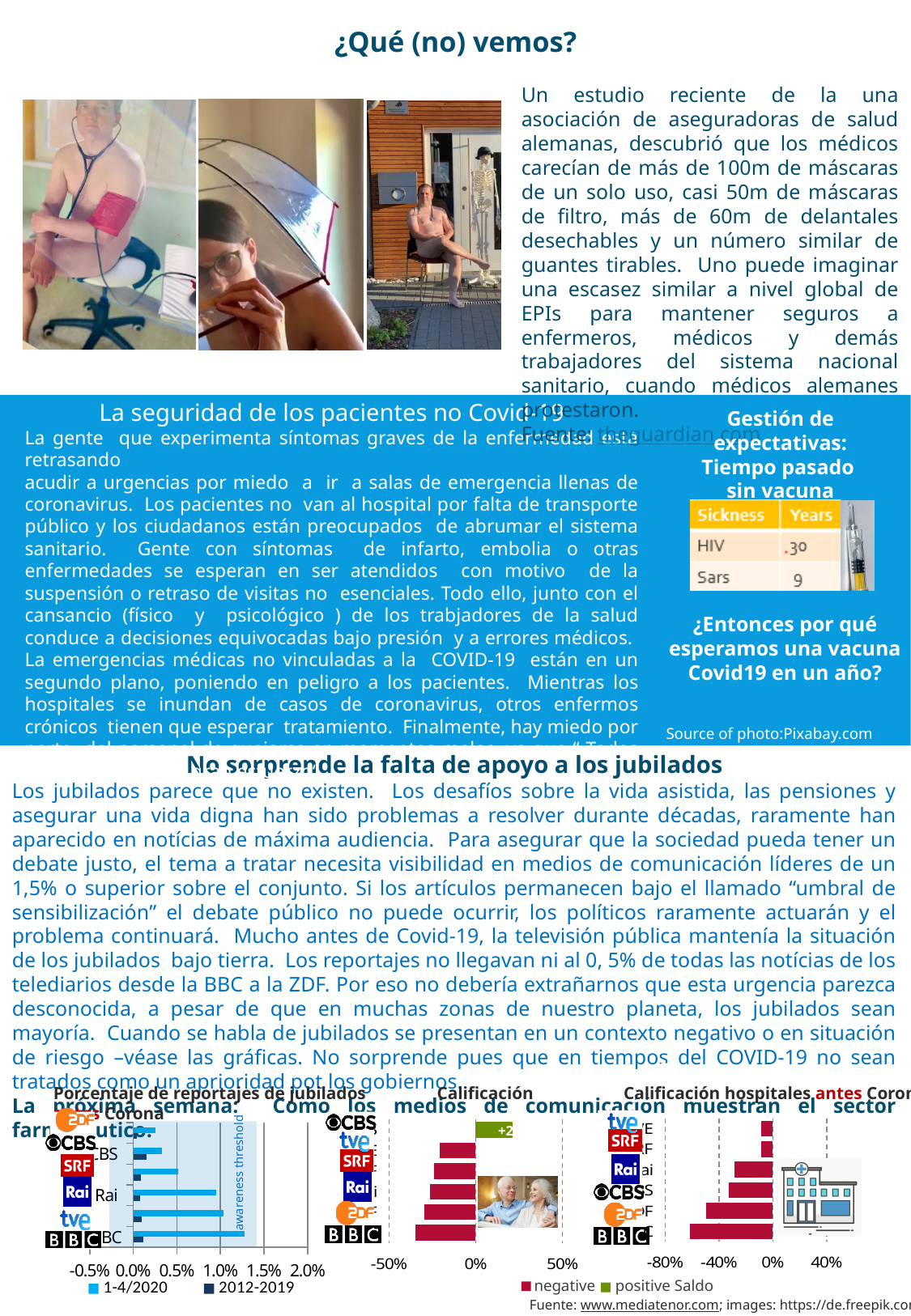
In the 'Porcentaje de reportajes de jubilados' chart, is the 1-4/2020 value for tve greater or less than 0.5%? greater In the 'Calificación' chart, which broadcaster has the lowest (most negative) value? BBC How many broadcasters are shown in the 'Porcentaje de reportajes de jubilados' chart? 6 In the 'Calificación hospitales antes Corona' chart, is the value for BBC greater or less than -40%? less What kind of chart is the 'Porcentaje de reportajes de jubilados' chart? bar chart In the 'Porcentaje de reportajes de jubilados' chart, is the 1-4/2020 value for Rai greater or less than 1.5%? less How many series does the legend of the 'Porcentaje de reportajes de jubilados' chart list? 2 In the 'Calificación hospitales antes Corona' chart, which broadcaster has the lowest (most negative) value? BBC In the 'Porcentaje de reportajes de jubilados' chart, what are the two series named in the legend? 1-4/2020 and 2012-2019 In the 'Porcentaje de reportajes de jubilados' chart, which is larger for 1-4/2020: tve or CBS? tve In the 'Calificación' chart, which broadcaster has the highest value? CBS